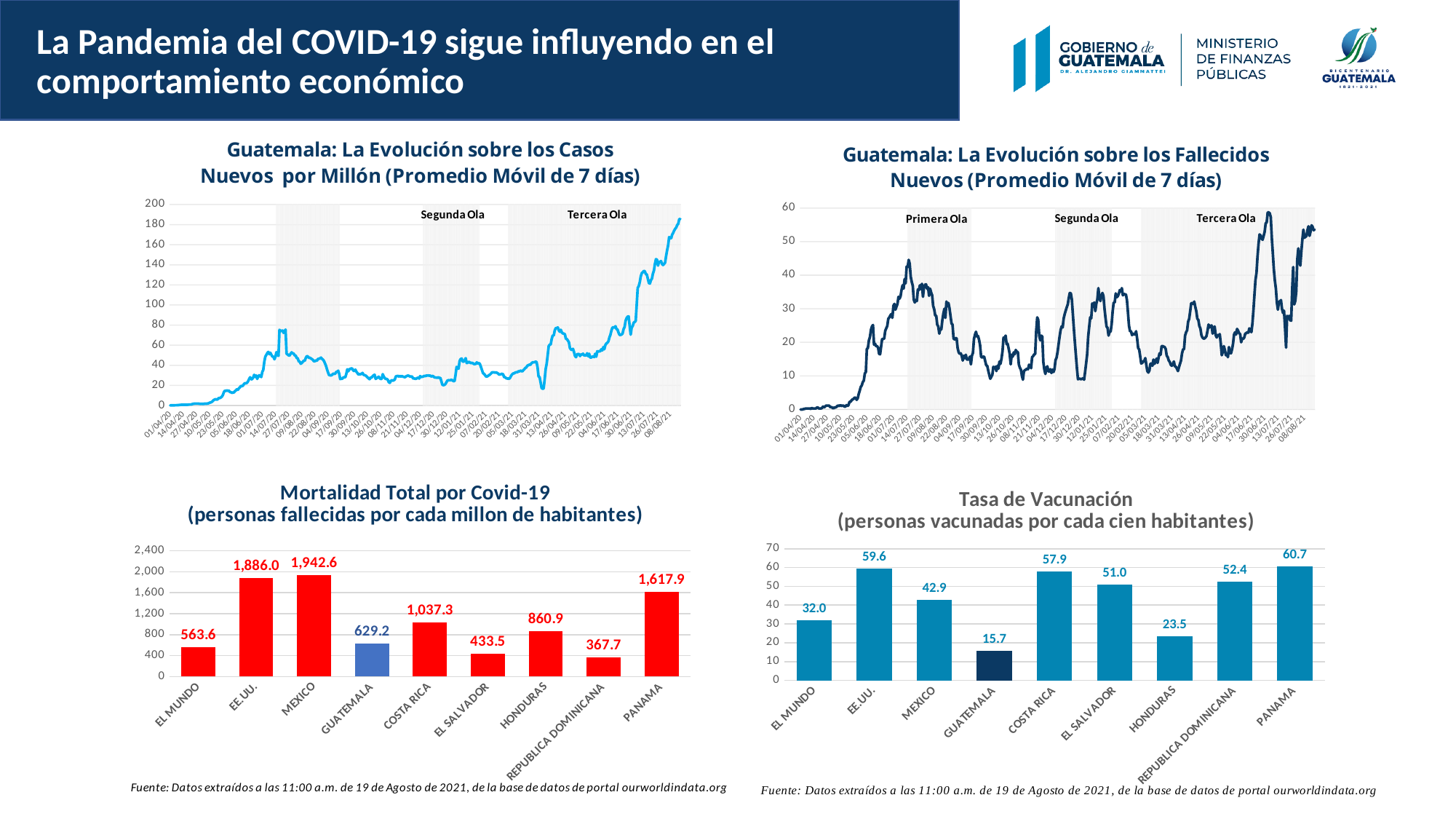
What kind of chart is 'Guatemala: La Evolución sobre los Casos Nuevos por Millón (Promedio Móvil de 7 días)'? line chart In the 'Tasa de Vacunación' chart, what is the difference between the values for PANAMA and EL MUNDO? 28.7 In the 'Mortalidad Total por Covid-19' chart, which bar is shown in a different colour (blue) from the others? GUATEMALA In the 'Mortalidad Total por Covid-19' chart, what is the value for GUATEMALA? 629.2 In the 'Mortalidad Total por Covid-19' chart, what is the difference between the values for MEXICO and EE.UU.? 56.6 In the 'Tasa de Vacunación' chart, which country has the highest value? PANAMA In the 'Tasa de Vacunación' chart, what is the value for GUATEMALA? 15.7 In the 'Tasa de Vacunación' chart, which is larger, the value for COSTA RICA or the value for EL SALVADOR? COSTA RICA In the 'Mortalidad Total por Covid-19' chart, which category has the lowest value? REPUBLICA DOMINICANA In the 'Mortalidad Total por Covid-19' chart, how many categories are shown? 9 In the 'Mortalidad Total por Covid-19' chart, which country has the highest value? MEXICO In the 'Guatemala: La Evolución sobre los Fallecidos Nuevos' chart, is the peak value during the Tercera Ola greater or less than 50? greater